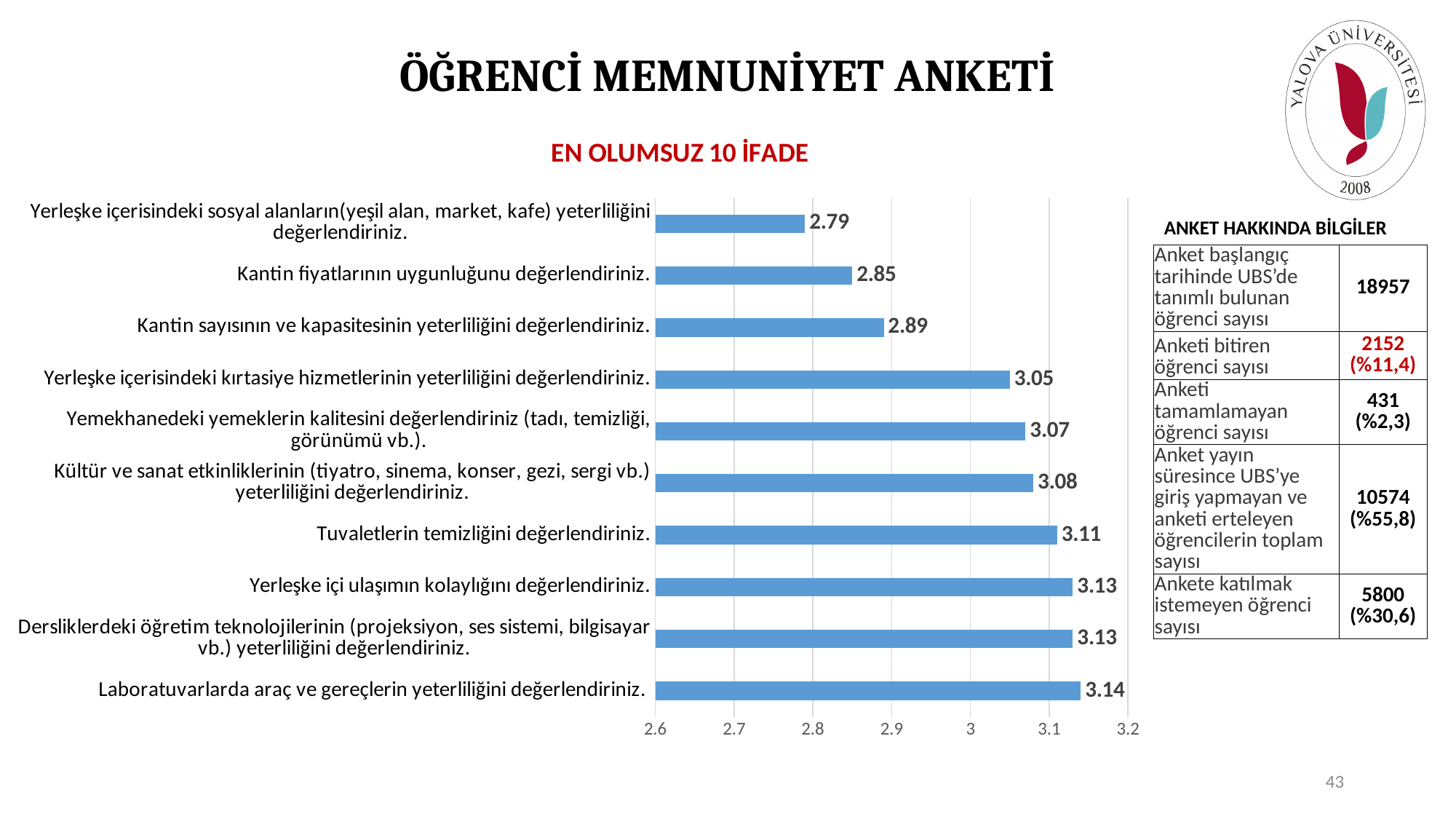
What is the value for "Yerleşke içerisindeki kırtasiye hizmetlerinin yeterliliğini değerlendiriniz."? 3.05 Which category has the lowest value? Yerleşke içerisindeki sosyal alanların(yeşil alan, market, kafe) yeterliliğini değerlendiriniz. Which category has the highest value? Laboratuvarlarda araç ve gereçlerin yeterliliğini değerlendiriniz. What is the value for "Kantin fiyatlarının uygunluğunu değerlendiriniz."? 2.85 What is the value for "Tuvaletlerin temizliğini değerlendiriniz."? 3.11 Which is larger: the value for "Yemekhanedeki yemeklerin kalitesini değerlendiriniz (tadı, temizliği, görünümü vb.)." or the value for "Kantin sayısının ve kapasitesinin yeterliliğini değerlendiriniz."? Yemekhanedeki yemeklerin kalitesini değerlendiriniz (tadı, temizliği, görünümü vb.). What is the title shown above the chart? EN OLUMSUZ 10 İFADE What kind of chart is shown on the slide? bar chart What is the difference between the value for "Kantin sayısının ve kapasitesinin yeterliliğini değerlendiriniz." and the value for "Kantin fiyatlarının uygunluğunu değerlendiriniz."? 0.04 How many categories are shown in the chart? 10 What is the difference between the value for "Laboratuvarlarda araç ve gereçlerin yeterliliğini değerlendiriniz." and the value for "Yerleşke içerisindeki sosyal alanların(yeşil alan, market, kafe) yeterliliğini değerlendiriniz."? 0.35 Is the value for "Kültür ve sanat etkinliklerinin (tiyatro, sinema, konser, gezi, sergi vb.) yeterliliğini değerlendiriniz." greater or less than 3? greater